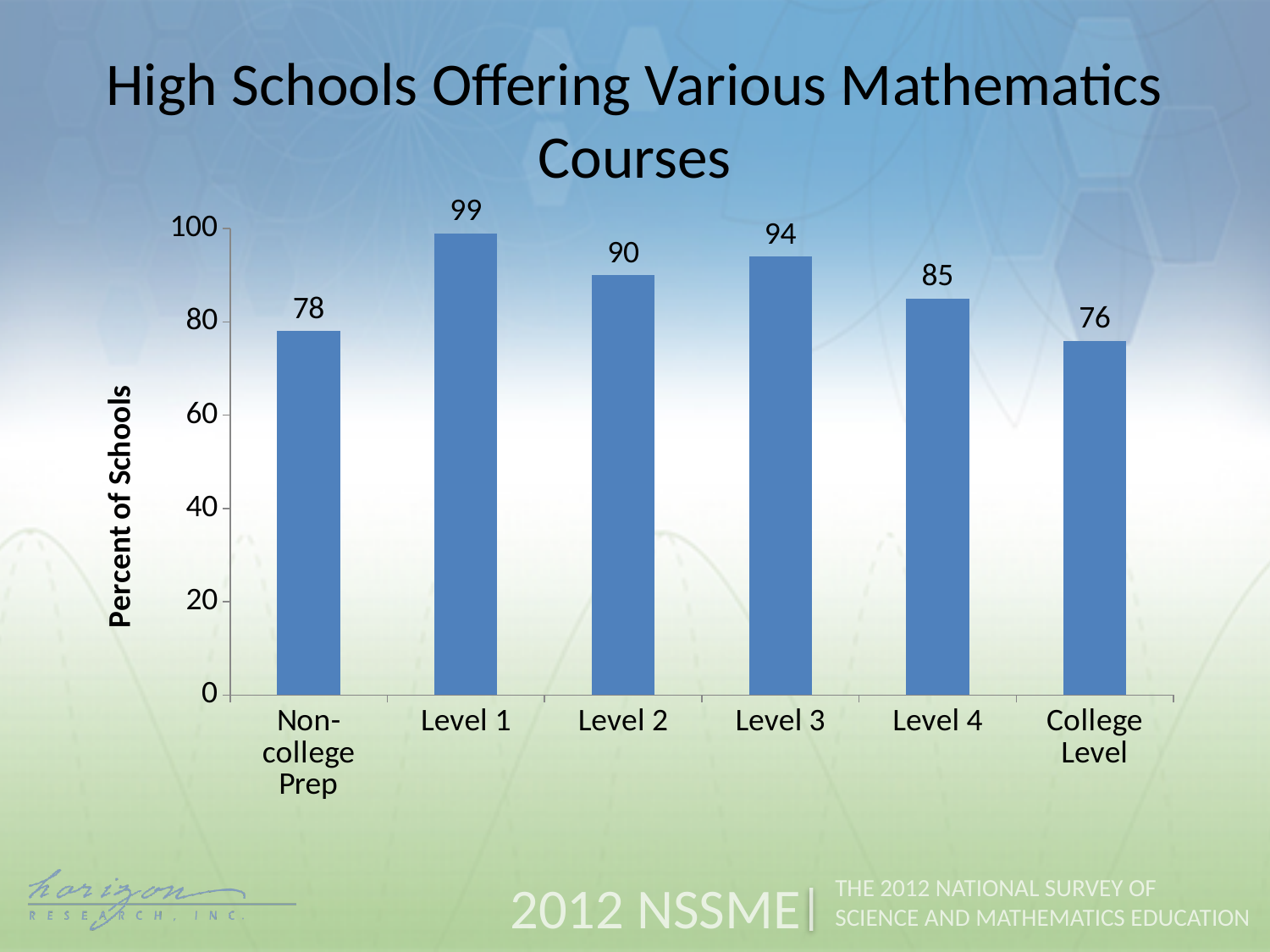
What is the label of the y axis? Percent of Schools Which course category has the highest percent of schools? Level 1 What is the value for College Level courses? 76 What is the difference between the values for Level 3 and Level 2? 4 What is the value for Non-college Prep courses? 78 What is the difference between the values for Level 1 and Level 4? 14 How many course categories are shown on the x axis? 6 Which is larger, the value for Level 2 or the value for Level 4? Level 2 What kind of chart is shown on the slide? bar chart What percent of schools offer Level 1 mathematics courses? 99 Which course category has the lowest percent of schools? College Level Is the value for Level 4 greater or less than 80? greater